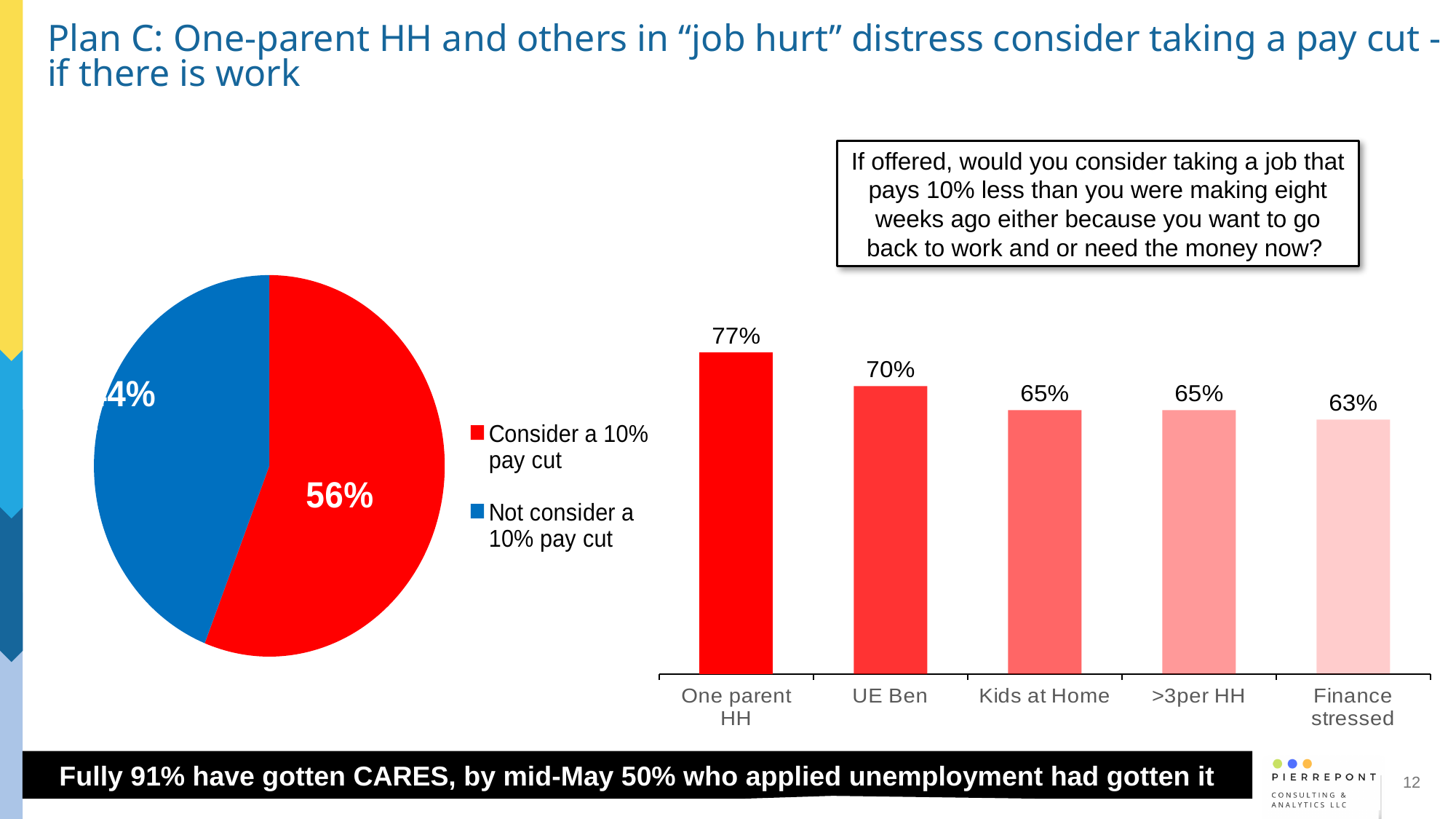
In the pie chart on the left, which slice is larger: 'Consider a 10% pay cut' or 'Not consider a 10% pay cut'? Consider a 10% pay cut In the bar chart on the right, what is the value for One parent HH? 77% In the pie chart on the left, what share of respondents would consider a 10% pay cut? 56% In the bar chart on the right, what is the value for UE Ben? 70% How many categories are shown in the bar chart on the right? 5 In the bar chart on the right, what is the value for Finance stressed? 63% In the bar chart on the right, which category has the lowest value? Finance stressed How many entries does the legend of the pie chart on the left list? 2 In the bar chart on the right, do the values rise or fall from left to right? Fall What kind of chart is the chart on the right side of the slide? Bar chart In the bar chart on the right, what is the difference between the values for One parent HH and UE Ben? 7 percentage points In the bar chart on the right, which category has the highest value? One parent HH